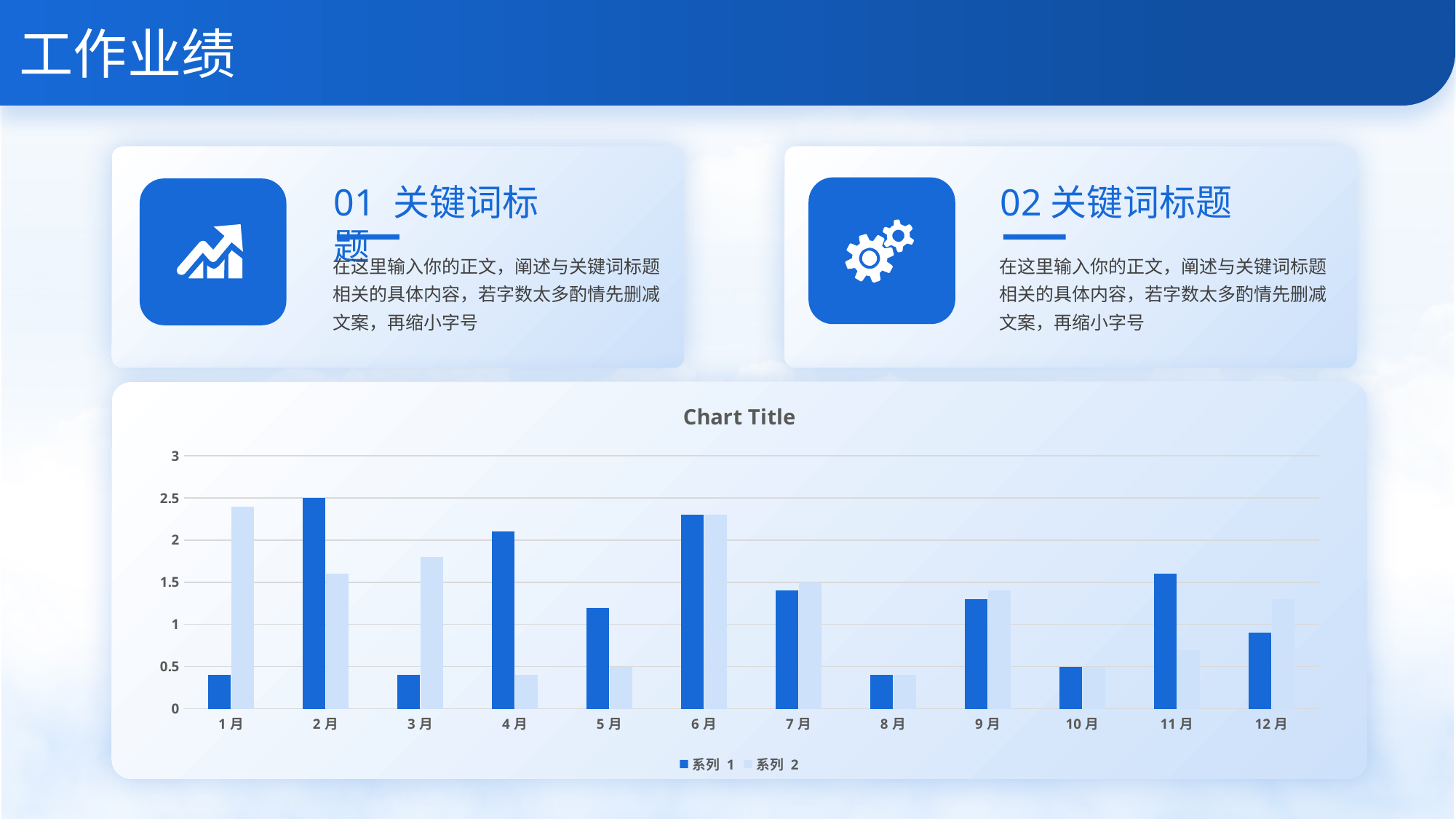
What is the value of 系列 1 for 2 月? 2.5 What kind of chart is shown on the slide? bar chart Which month has the highest value for 系列 1? 2 月 Is the value of 系列 1 for 1 月 greater or less than 0.5? less For 1 月, which series has the larger value, 系列 1 or 系列 2? 系列 2 How many series does the chart legend list? 2 Is the value of 系列 2 for 3 月 greater or less than 1.5? greater What is the value of 系列 2 for 5 月? 0.5 What is the title of the chart? Chart Title How many categories are shown on the x axis of the chart? 12 For 5 月, which series has the larger value, 系列 1 or 系列 2? 系列 1 Is the value of 系列 1 for 6 月 greater or less than 2? greater